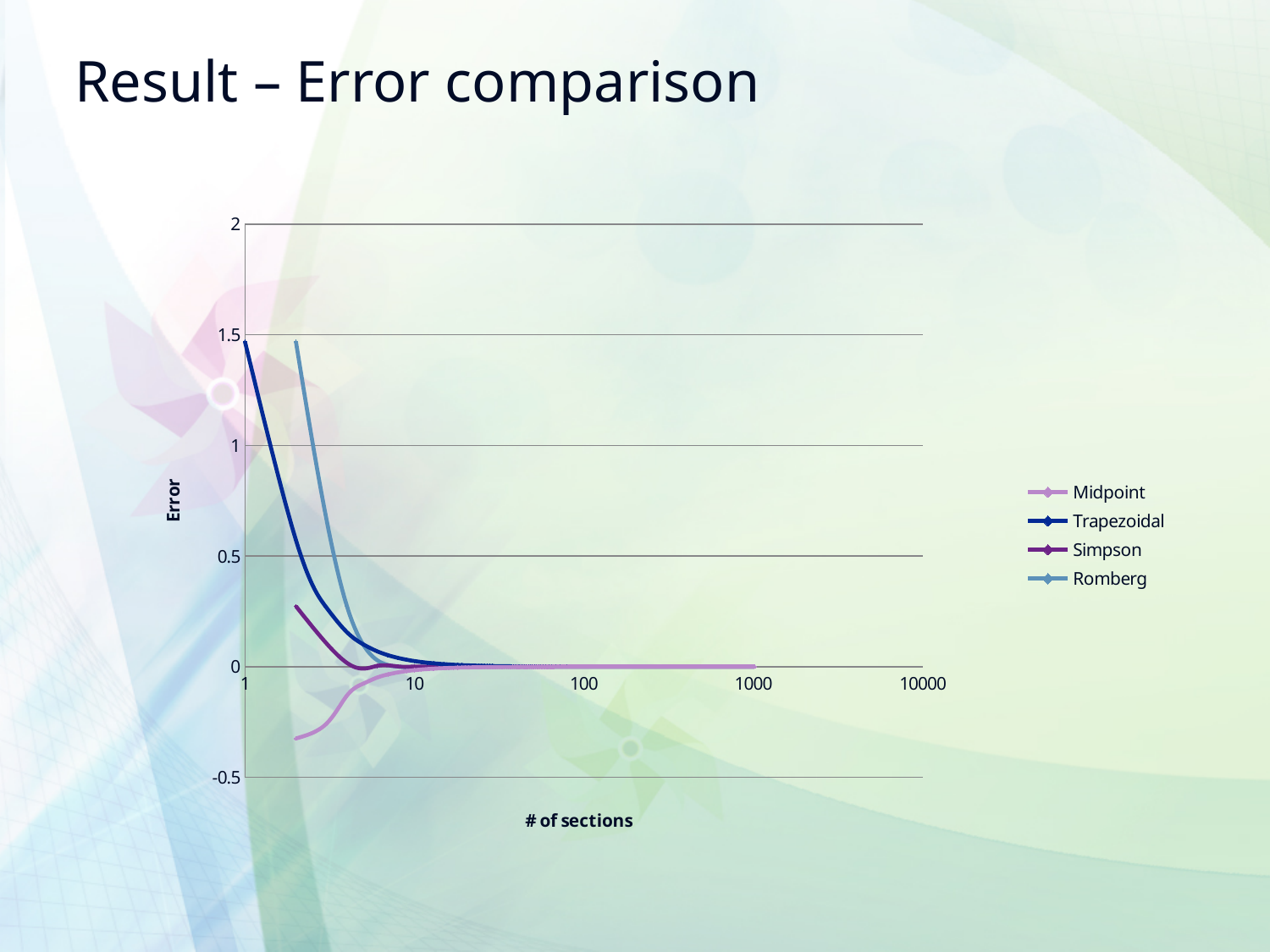
At the leftmost point of each series, which has the larger error, Trapezoidal or Simpson? Trapezoidal Is the Trapezoidal error at 1 section greater or less than 1? greater Is the Midpoint error at its leftmost point greater or less than 0? less What is the title of the x axis? # of sections How many series does the legend list? 4 What are the series names listed in the legend? Midpoint, Trapezoidal, Simpson, Romberg Does the Midpoint error rise or fall as the number of sections increases? rise Does the Trapezoidal error rise or fall as the number of sections increases? fall Does the Romberg error rise or fall as the number of sections increases? fall What kind of chart is shown on the slide? line chart Which series is the only one with negative error values? Midpoint Is the Simpson error at its leftmost point greater or less than 0.5? less